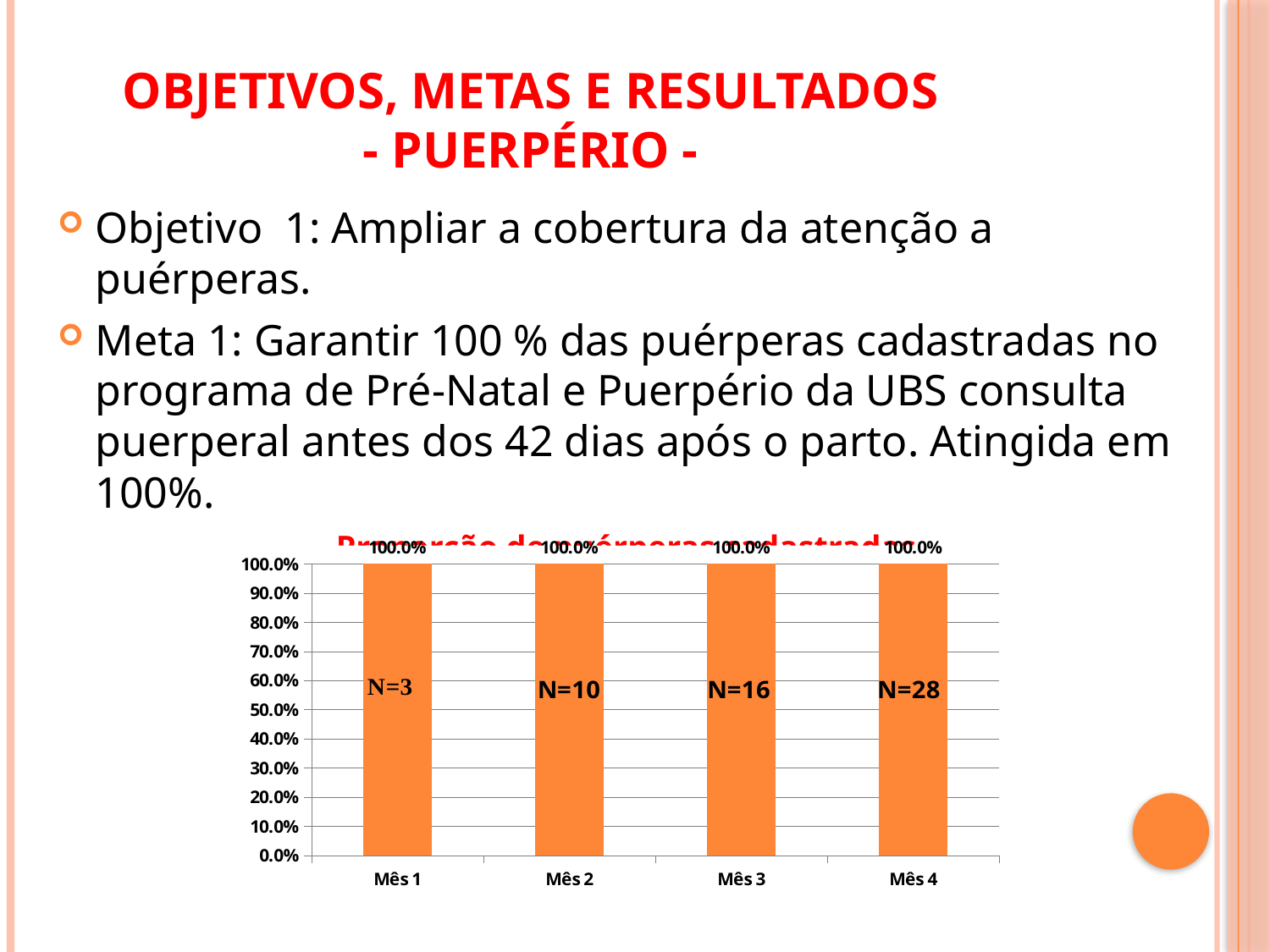
What kind of chart is shown on the slide? bar chart Is the value for Mês 2 greater or less than 90.0%? greater What N value is printed on the bar for Mês 4? N=28 What is the difference between the values for Mês 4 and Mês 1? 0.0% What is the value for Mês 1? 100.0% What is the value for Mês 2? 100.0% What N value is printed on the bar for Mês 3? N=16 How many categories (months) are shown on the x axis of the chart? 4 Do the values rise, fall or stay the same from Mês 1 to Mês 4? stay the same What is the value for Mês 3? 100.0% What is the value for Mês 4? 100.0%